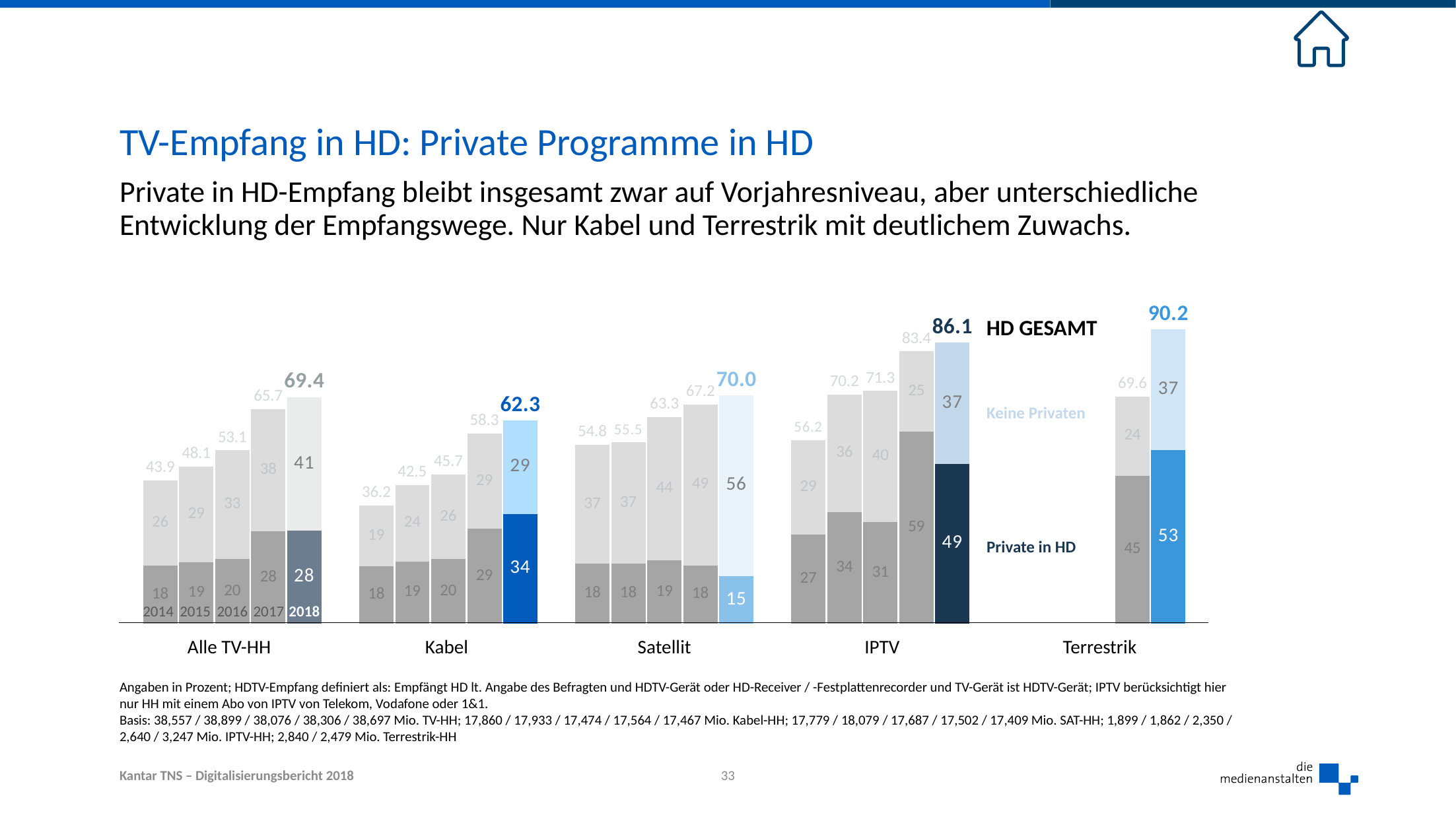
Which reception path has the highest HD GESAMT value in 2018? Terrestrik What kind of chart is shown on the slide? stacked bar chart Does the HD GESAMT value for Alle TV-HH rise or fall from 2014 to 2018? rise Which reception path has the lowest HD GESAMT value in 2018? Kabel By how much did the Private in HD value for Kabel change from 2017 to 2018? 5 Is the Private in HD value for IPTV in 2018 larger or smaller than for Satellit in 2018? larger What is the Private in HD value for Kabel in 2018? 34 What is the HD GESAMT value for Terrestrik in 2018? 90.2 What is the difference between the HD GESAMT values for Terrestrik in 2018 and 2017? 20.6 What is the Keine Privaten value for Satellit in 2018? 56 How many reception path groups are shown on the x axis? 5 What is the HD GESAMT value for IPTV in 2017? 83.4